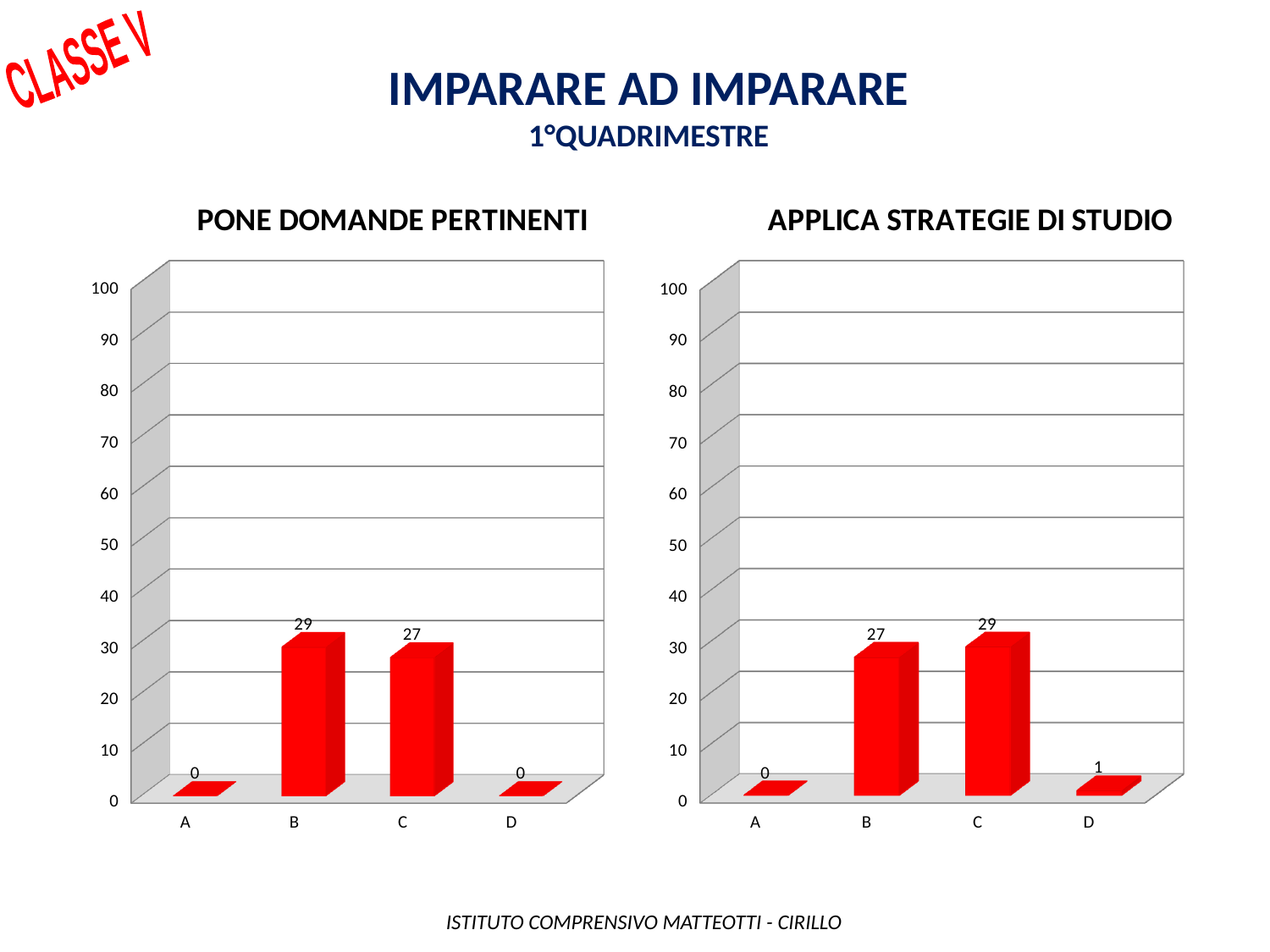
In the 'PONE DOMANDE PERTINENTI' chart, what is the value for category C? 27 What kind of chart is the 'PONE DOMANDE PERTINENTI' chart? bar chart In the 'APPLICA STRATEGIE DI STUDIO' chart, what is the difference between the values for C and D? 28 In the 'APPLICA STRATEGIE DI STUDIO' chart, what is the value for category D? 1 In the 'PONE DOMANDE PERTINENTI' chart, is the value for B greater or less than 40? less In the 'APPLICA STRATEGIE DI STUDIO' chart, which is larger, the value for B or the value for C? C How many categories are shown on the x axis of the 'APPLICA STRATEGIE DI STUDIO' chart? 4 In the 'PONE DOMANDE PERTINENTI' chart, which category has the highest value? B In the 'PONE DOMANDE PERTINENTI' chart, what is the value for category B? 29 In the 'APPLICA STRATEGIE DI STUDIO' chart, which category has the highest value? C In the 'PONE DOMANDE PERTINENTI' chart, what is the difference between the values for B and C? 2 In the 'APPLICA STRATEGIE DI STUDIO' chart, what is the value for category B? 27